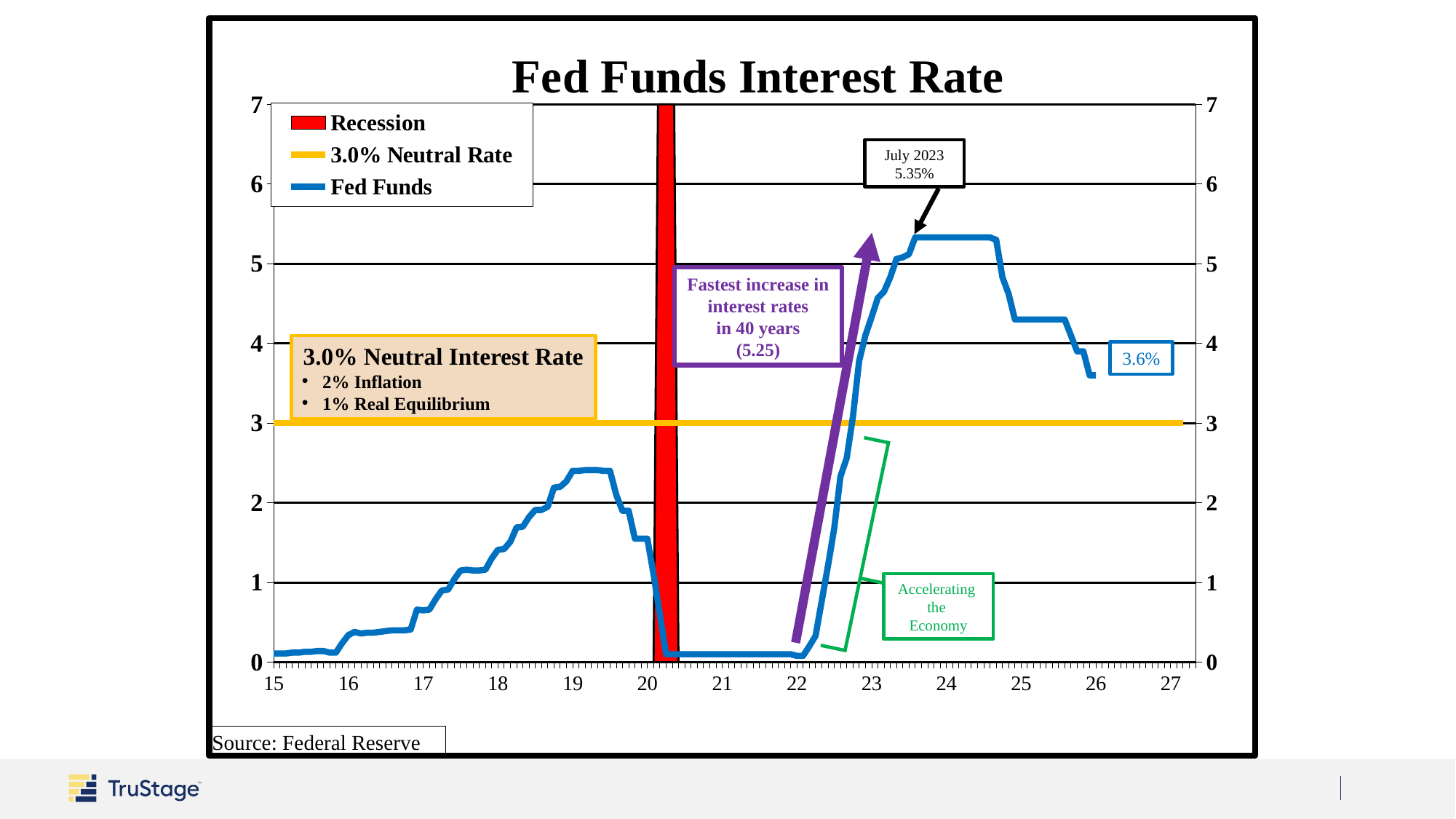
What is the difference between the July 2023 rate of 5.35% and the labelled end value of 3.6%? 1.75% How many entries does the chart's legend list? 3 Which is higher: the Fed Funds peak in 2019 or the peak in 2023? 2023 What value is the neutral interest rate line drawn at? 3.0% Is the Fed Funds rate in 2021 greater or less than 1? less According to the annotation, how large was the fastest increase in interest rates in 40 years? 5.25 Is the Fed Funds rate at the start of 2025 greater or less than 4? greater What type of chart is shown on the slide? line chart What Fed Funds rate is labelled for July 2023? 5.35% Does the Fed Funds line rise or fall between 2022 and 2023? rise What Fed Funds rate is labelled at the end of the blue line, around 2026? 3.6% What is the title of the chart? Fed Funds Interest Rate